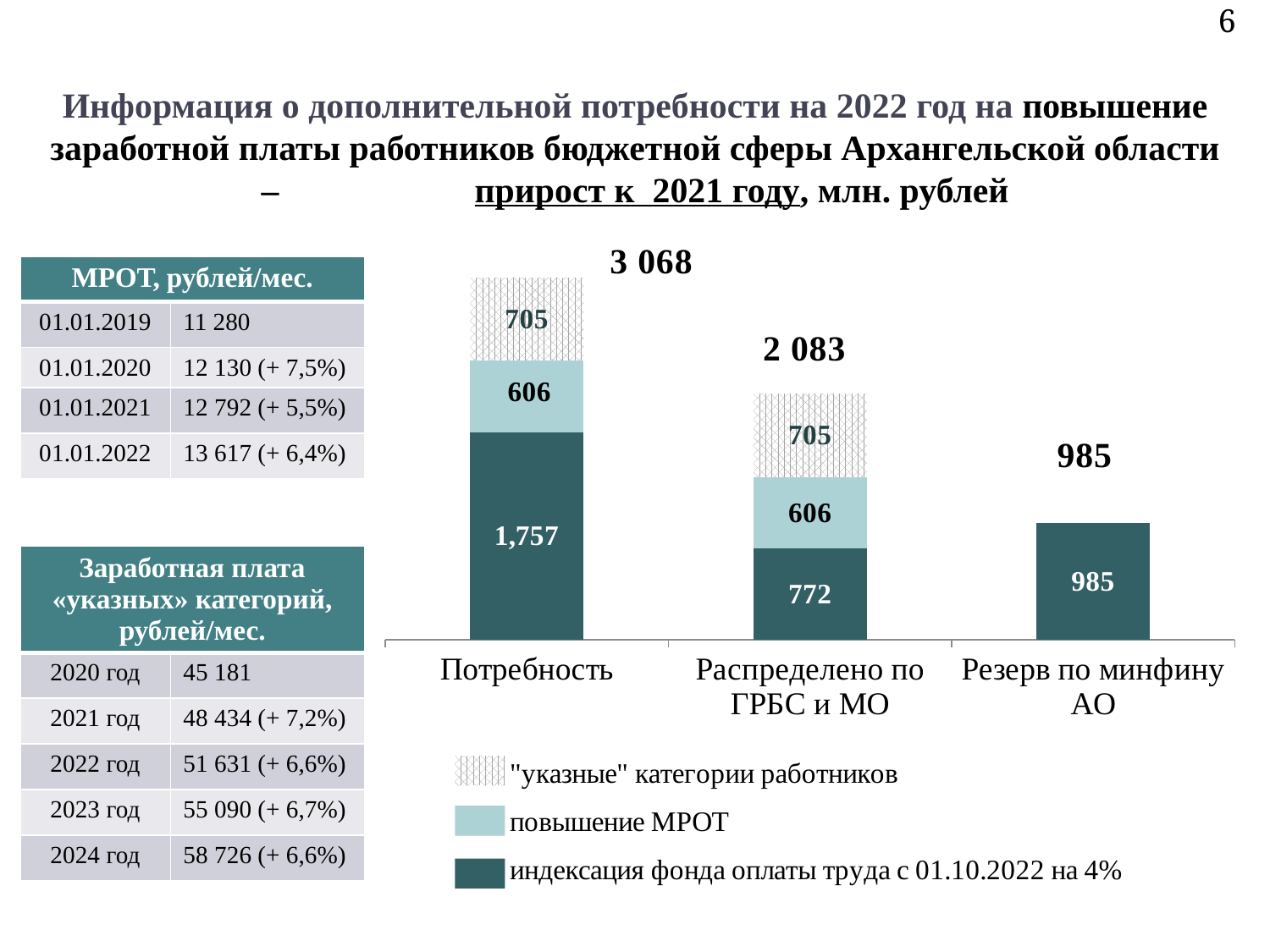
What is the value of the "повышение МРОТ" segment for "Потребность"? 606 What is the total value of the stacked bar for "Потребность"? 3 068 What is the difference between the totals for "Потребность" and "Распределено по ГРБС и МО"? 985 What is the value of the ""указные" категории работников" segment for "Распределено по ГРБС и МО"? 705 Which category has the highest total value? Потребность How many series does the chart legend list? 3 What is the value of the "индексация фонда оплаты труда с 01.10.2022 на 4%" segment for "Потребность"? 1,757 What type of chart is shown on the slide? stacked bar chart What is the total value of the stacked bar for "Распределено по ГРБС и МО"? 2 083 What is the value of the "индексация фонда оплаты труда с 01.10.2022 на 4%" segment for "Распределено по ГРБС и МО"? 772 How many categories are shown on the x axis of the chart? 3 What is the value shown for "Резерв по минфину АО"? 985